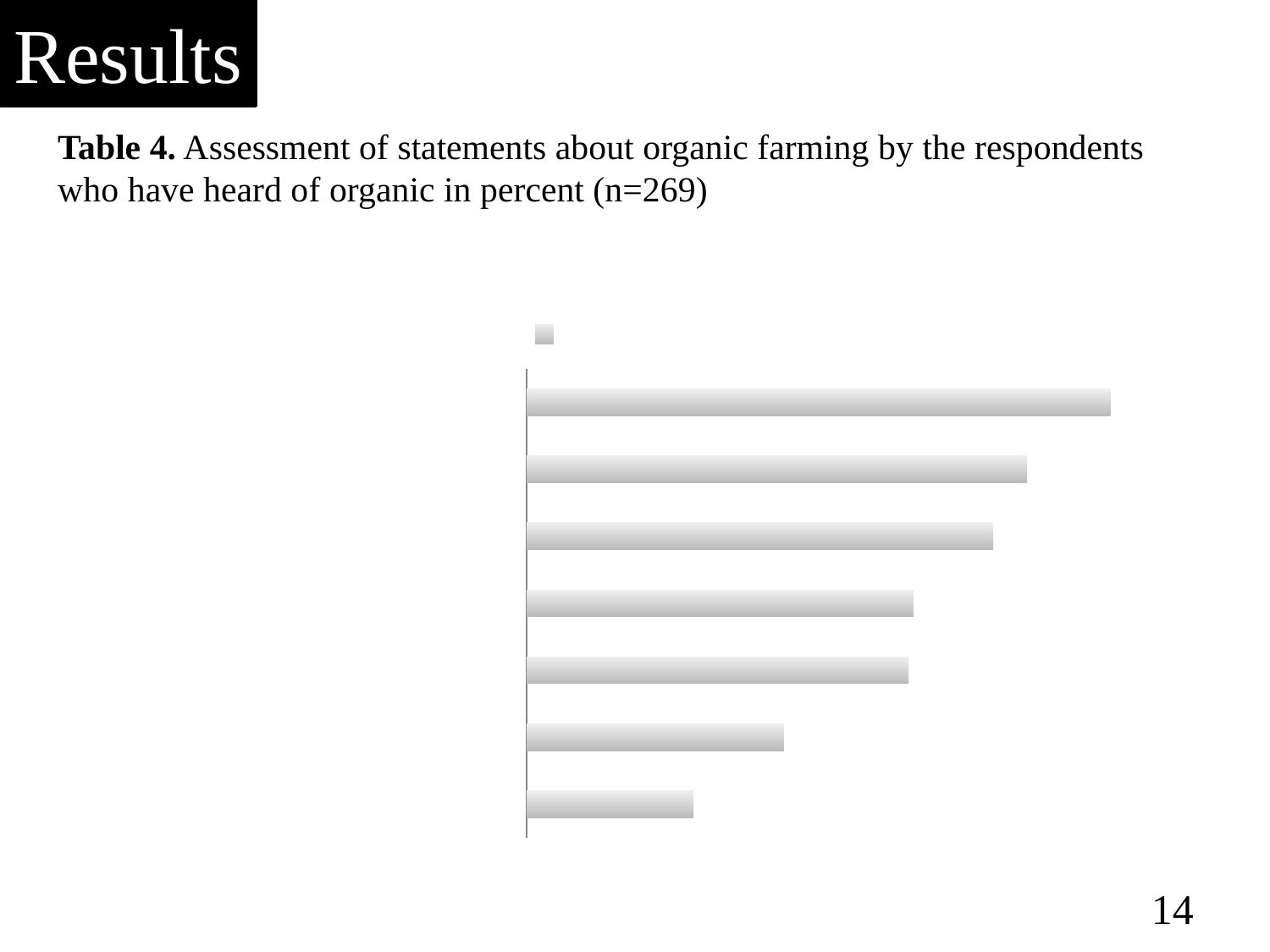
What kind of chart is shown on the slide? bar chart Are the bars in the chart horizontal or vertical? horizontal What is the sample size (n) stated in the caption above the chart? 269 Which bar is longer, the second bar from the top or the second bar from the bottom? the second bar from the top Which bar is longer, the top bar or the bottom bar? the top bar Do the bars get longer or shorter going from the top of the chart to the bottom? shorter How many bars does the chart contain? 7 How many series does the chart's legend list? 1